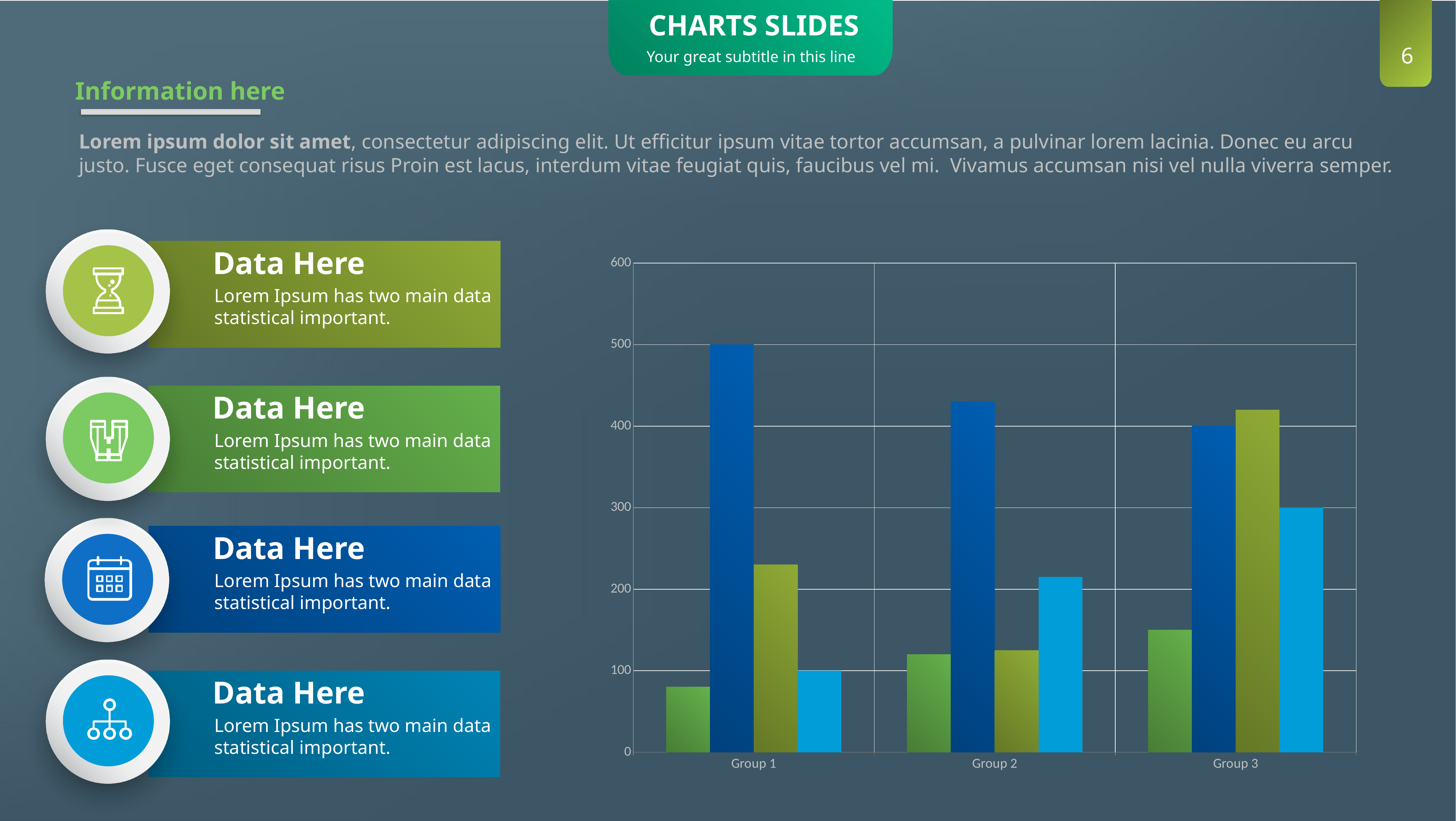
Is the value of the green bar for Group 1 greater or less than 100? less What is the value of the dark blue bar for Group 3? 400 Which group has the tallest bar in the chart? Group 1 What is the value of the dark blue bar for Group 1? 500 What kind of chart is shown on the slide? bar chart What is the value of the light blue bar for Group 1? 100 Is the value of the dark blue bar for Group 2 greater or less than 400? greater What is the value of the light blue bar for Group 3? 300 How many bars are plotted for each group in the chart? 4 How many category groups are shown on the x axis of the chart? 3 Is the value of the olive bar for Group 3 greater or less than 400? greater Which is larger in Group 2: the light blue bar or the olive bar? the light blue bar